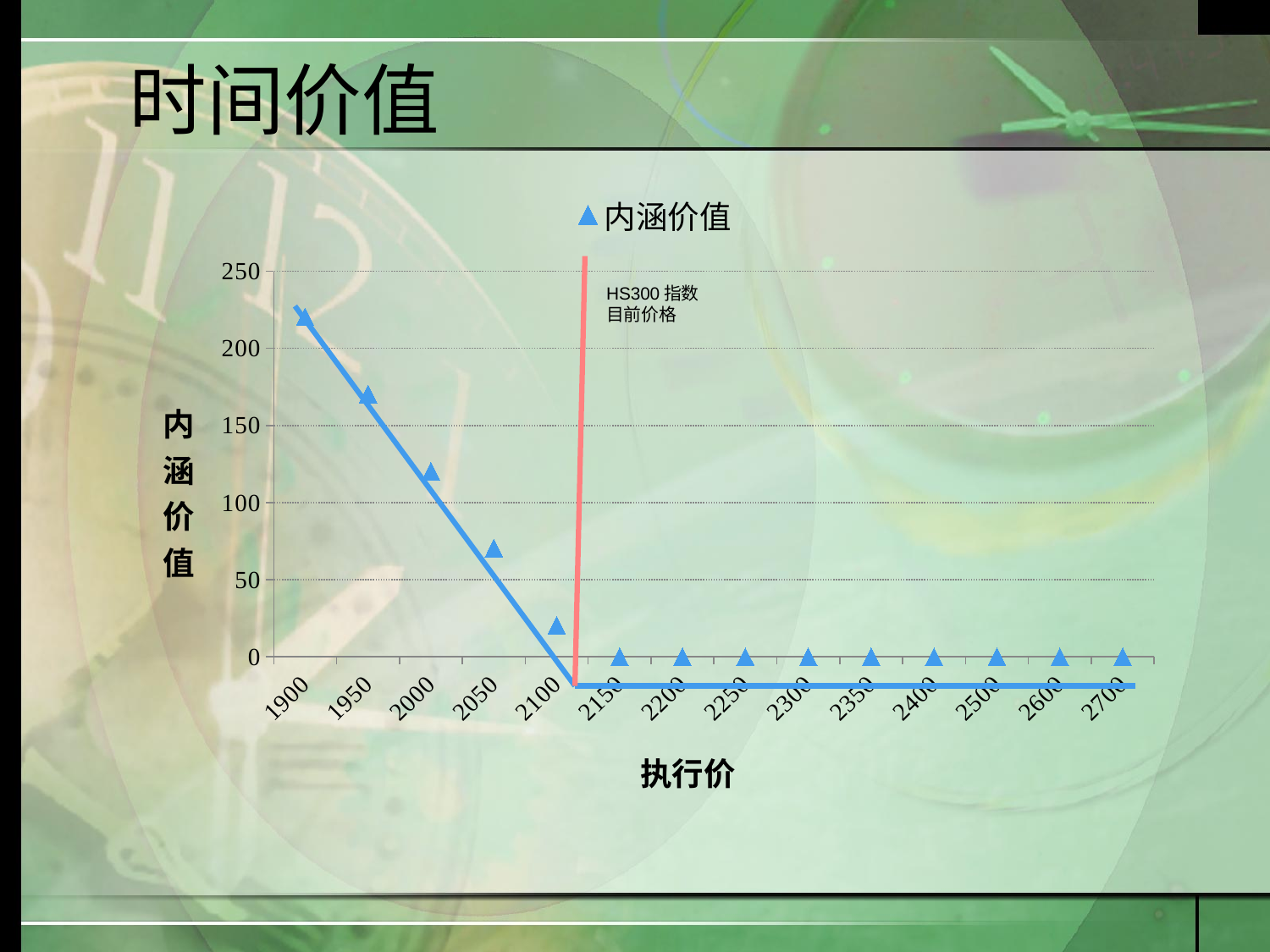
Is the value of the data point near 执行价 2500 greater or less than 50? less What is the name of the series shown in the legend? 内涵价值 What kind of chart is shown on the slide? line chart Is the value of the leftmost data point (near 执行价 1900) greater or less than 200? greater Is the value of the data point near 执行价 2100 greater or less than 50? less How do the 内涵价值 values change as 执行价 increases from 1900 to 2100? they fall Which is larger: the 内涵价值 near 执行价 1950 or near 执行价 2050? near 1950 What is the title of the x axis? 执行价 How many series does the legend list? 1 Which data point has the highest 内涵价值? the leftmost point, near 执行价 1900 What does the red vertical line on the chart mark? HS300 指数目前价格